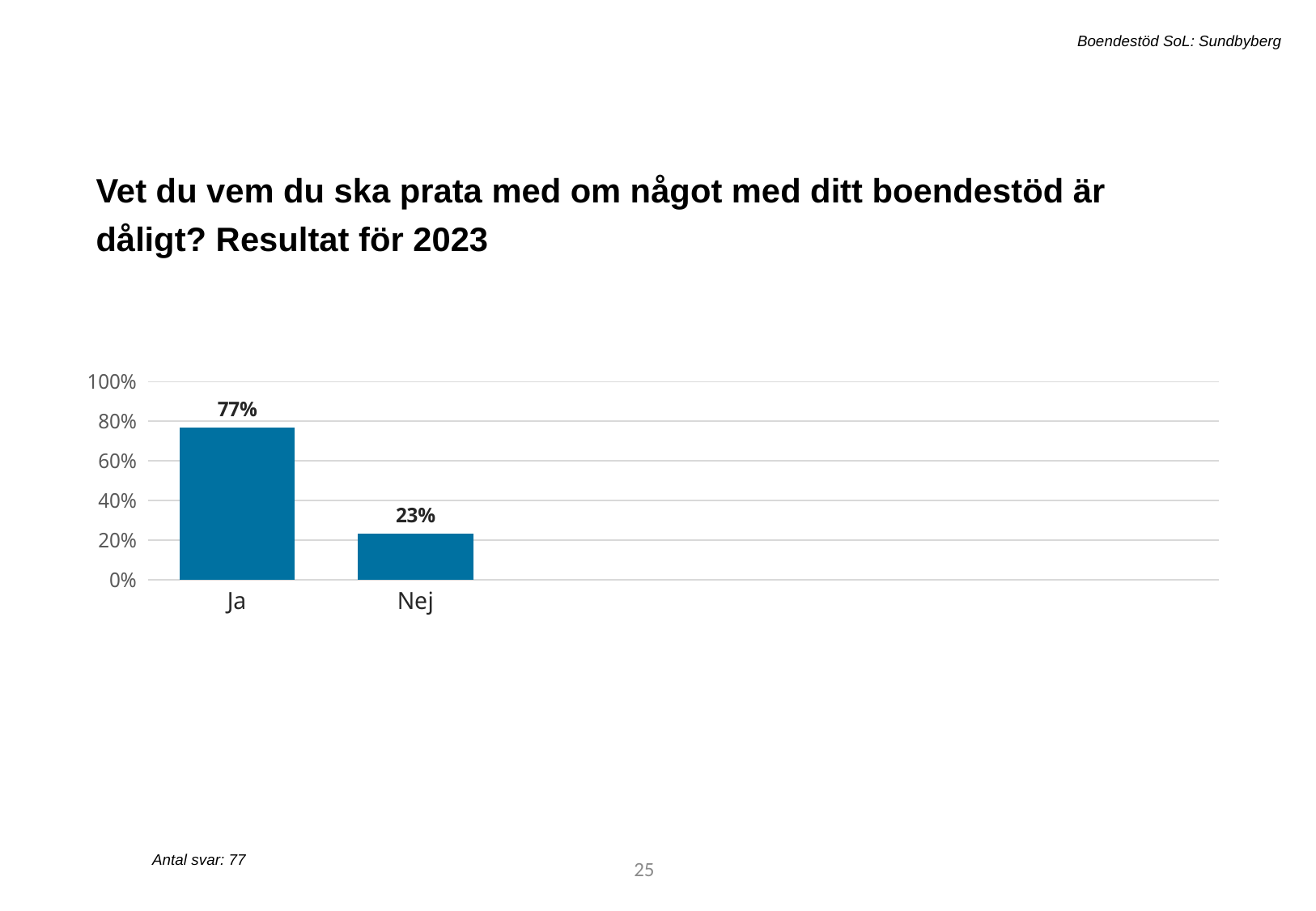
What is the difference between the values for Ja and Nej? 54% What is the number of responses (Antal svar) stated on the slide? 77 How many categories are shown on the x axis? 2 Is the value for Ja greater or less than 60%? greater Which category has the highest value? Ja What is the total of the values for Ja and Nej? 100% Is the value for Nej greater or less than 40%? less What is the value for Ja? 77% Which is larger, the value for Ja or the value for Nej? Ja What kind of chart is shown on the slide? bar chart What is the value for Nej? 23% Which category has the lowest value? Nej